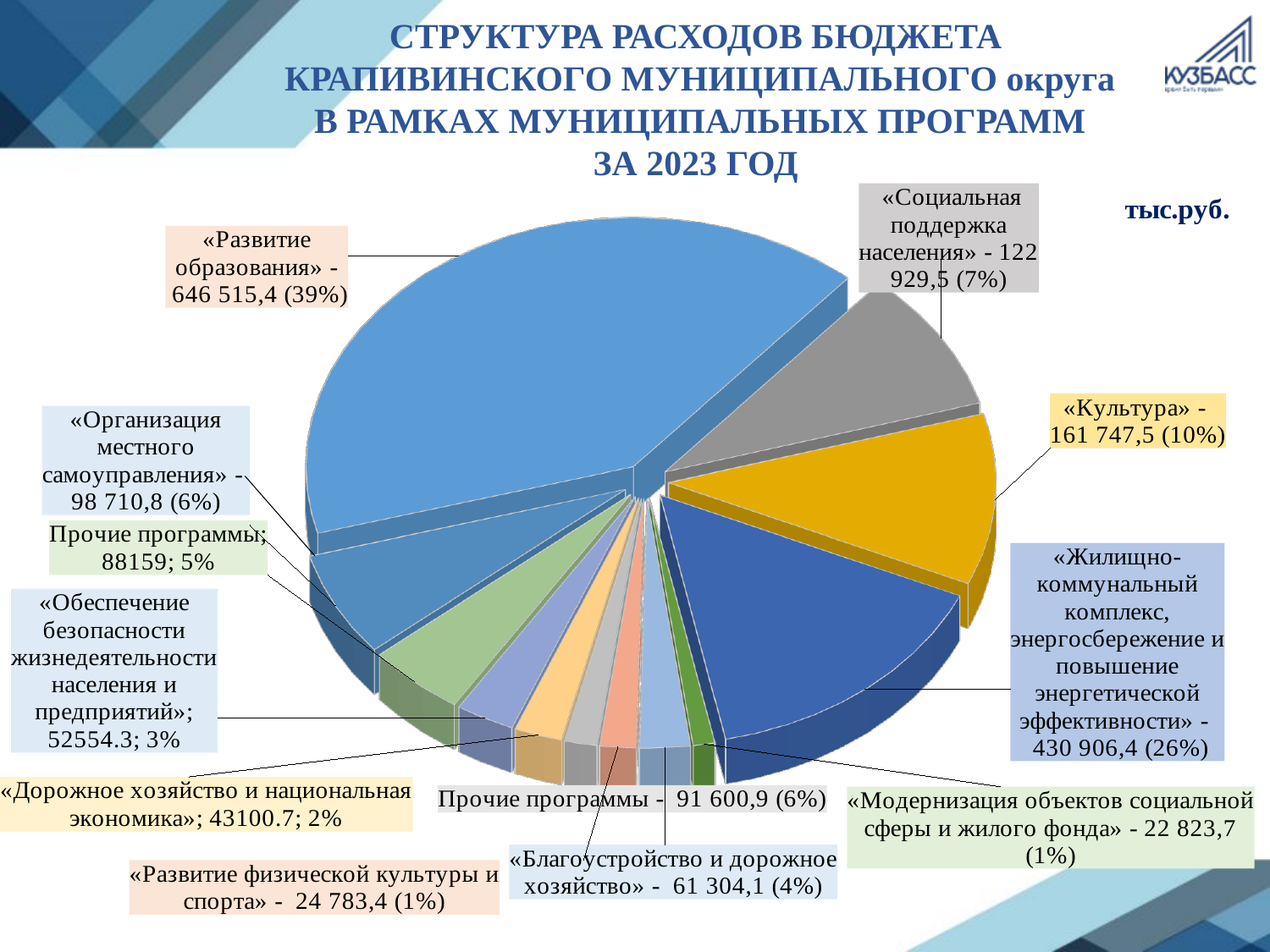
What share of the pie does «Развитие образования» take? 39% What is the expenditure value for «Социальная поддержка населения»? 122 929,5 Which program has the largest share of budget expenditures? «Развитие образования» Which is larger: the expenditure for «Культура» or for «Организация местного самоуправления»? «Культура» What is the expenditure value for «Культура»? 161 747,5 For which year does the chart show the budget expenditure structure? 2023 What is the difference in percentage share between «Развитие образования» and «Жилищно-коммунальный комплекс, энергосбережение и повышение энергетической эффективности»? 13% In what units are the values on the chart given? тыс.руб. What kind of chart is shown on the slide? pie chart What share of the pie does «Жилищно-коммунальный комплекс, энергосбережение и повышение энергетической эффективности» take? 26% Which program has the smallest expenditure value? «Модернизация объектов социальной сферы и жилого фонда» What is the expenditure value for «Благоустройство и дорожное хозяйство»? 61 304,1